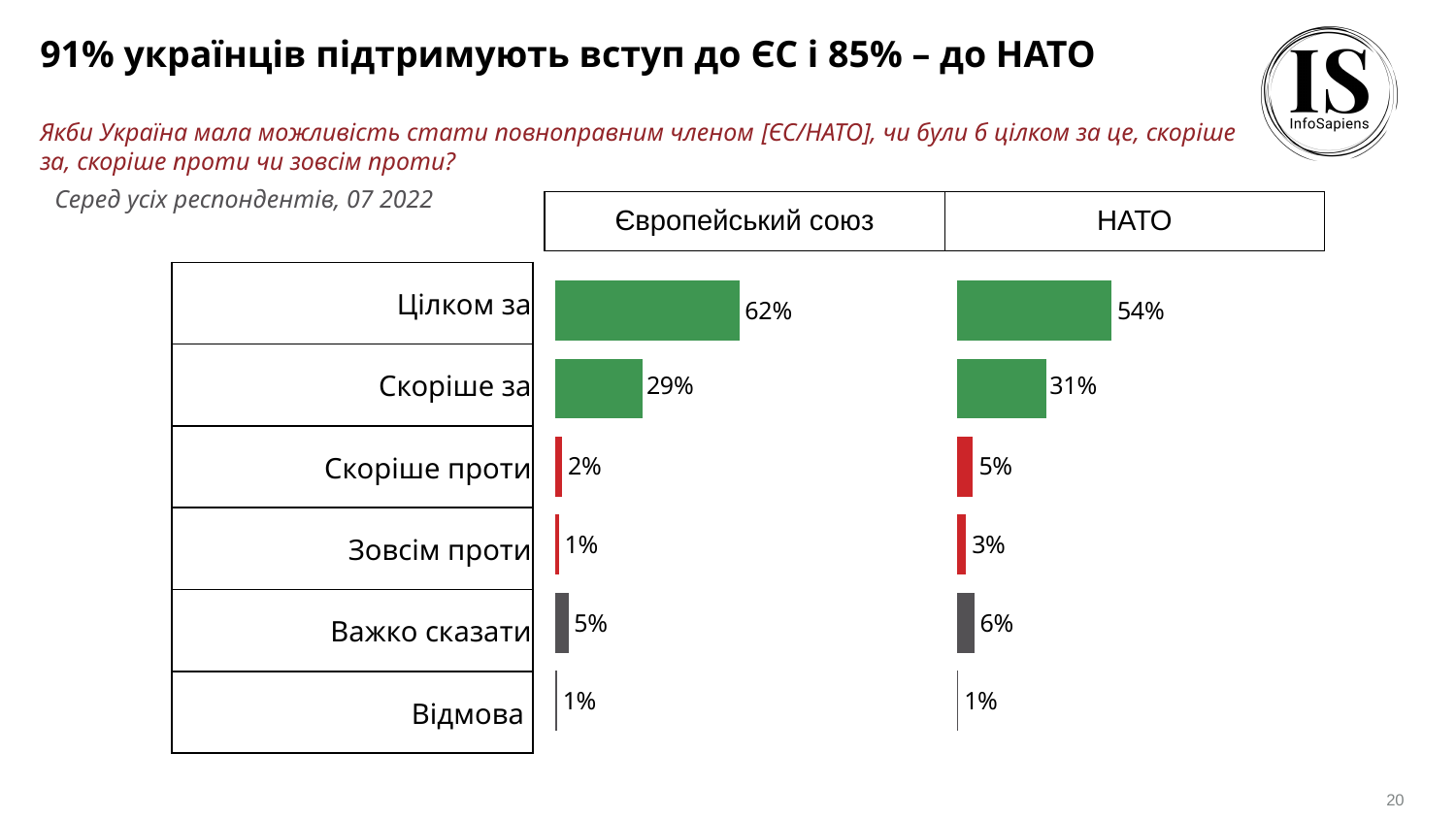
What is the difference between the Цілком за values in the Європейський союз chart and the НАТО chart? 8% In the НАТО chart, what is the value for Скоріше проти? 5% How many categories are shown in the Європейський союз chart? 6 In the Європейський союз chart, what is the value for Важко сказати? 5% Which chart has the larger value for Зовсім проти, Європейський союз or НАТО? НАТО What colour are the bars for Скоріше проти and Зовсім проти in both charts? Red In the НАТО chart, which category has the highest value? Цілком за In the Європейський союз chart, which category has the lowest value, Скоріше проти or Зовсім проти? Зовсім проти What type of chart is used for the НАТО data? Bar chart In the Європейський союз chart, what is the value for Цілком за? 62% In the НАТО chart, what is the difference between Цілком за and Скоріше за? 23% In the НАТО chart, what is the value for Скоріше за? 31%